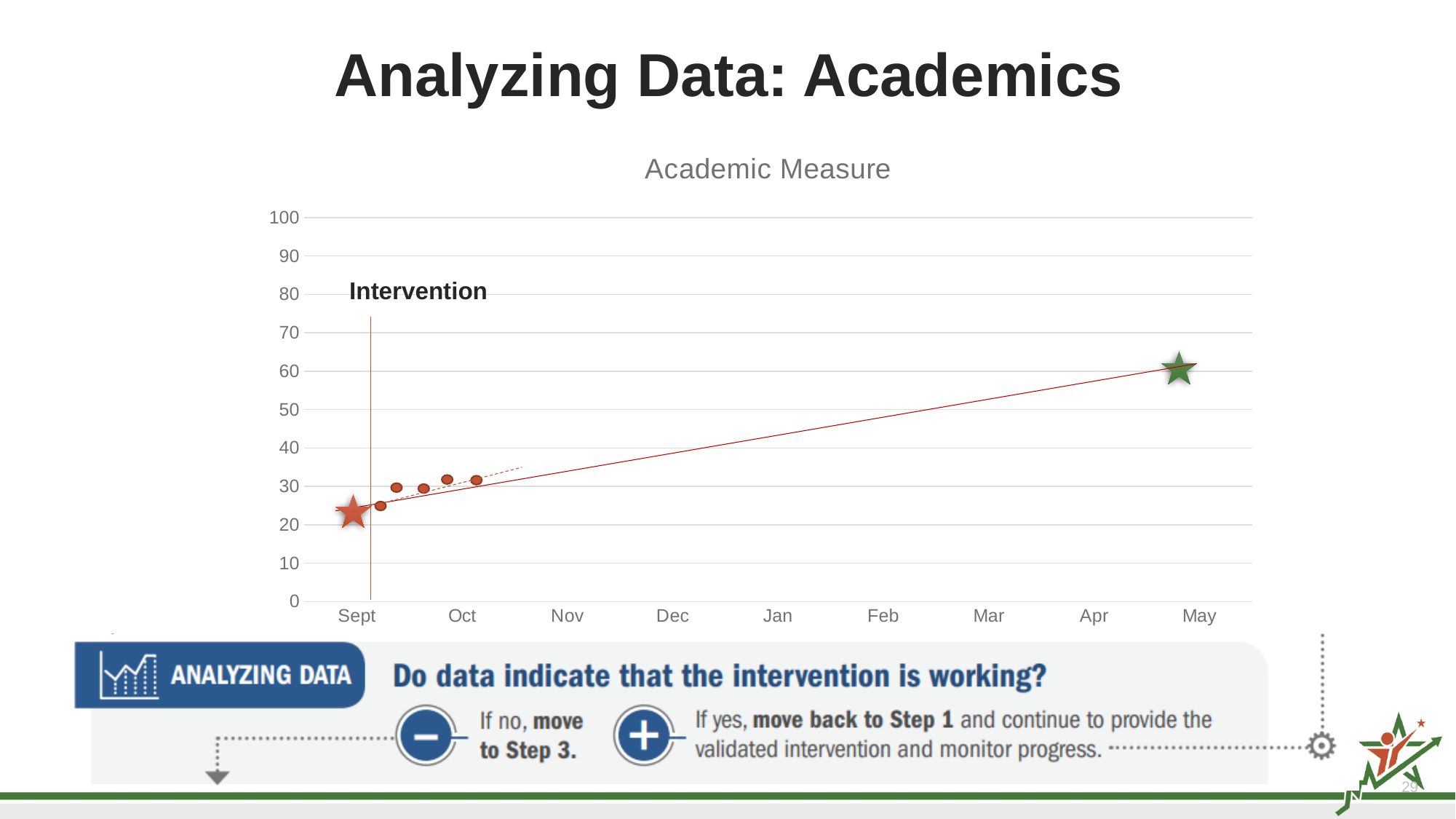
Are the plotted data points around Oct greater or less than 40? less What is the highest value shown on the y axis? 100 What is the title of the chart? Academic Measure Which is larger, the value at the green star (May) or the value at the red star (Sept)? the green star (May) What is the first month labelled on the x axis? Sept Is the value marked by the green star at May greater or less than 50? greater Is the value marked by the red star at Sept greater or less than 30? less Does the red trend line rise or fall from Sept to May? rise What kind of chart is shown on the slide? line chart How many months are labelled on the x axis of the chart? 9